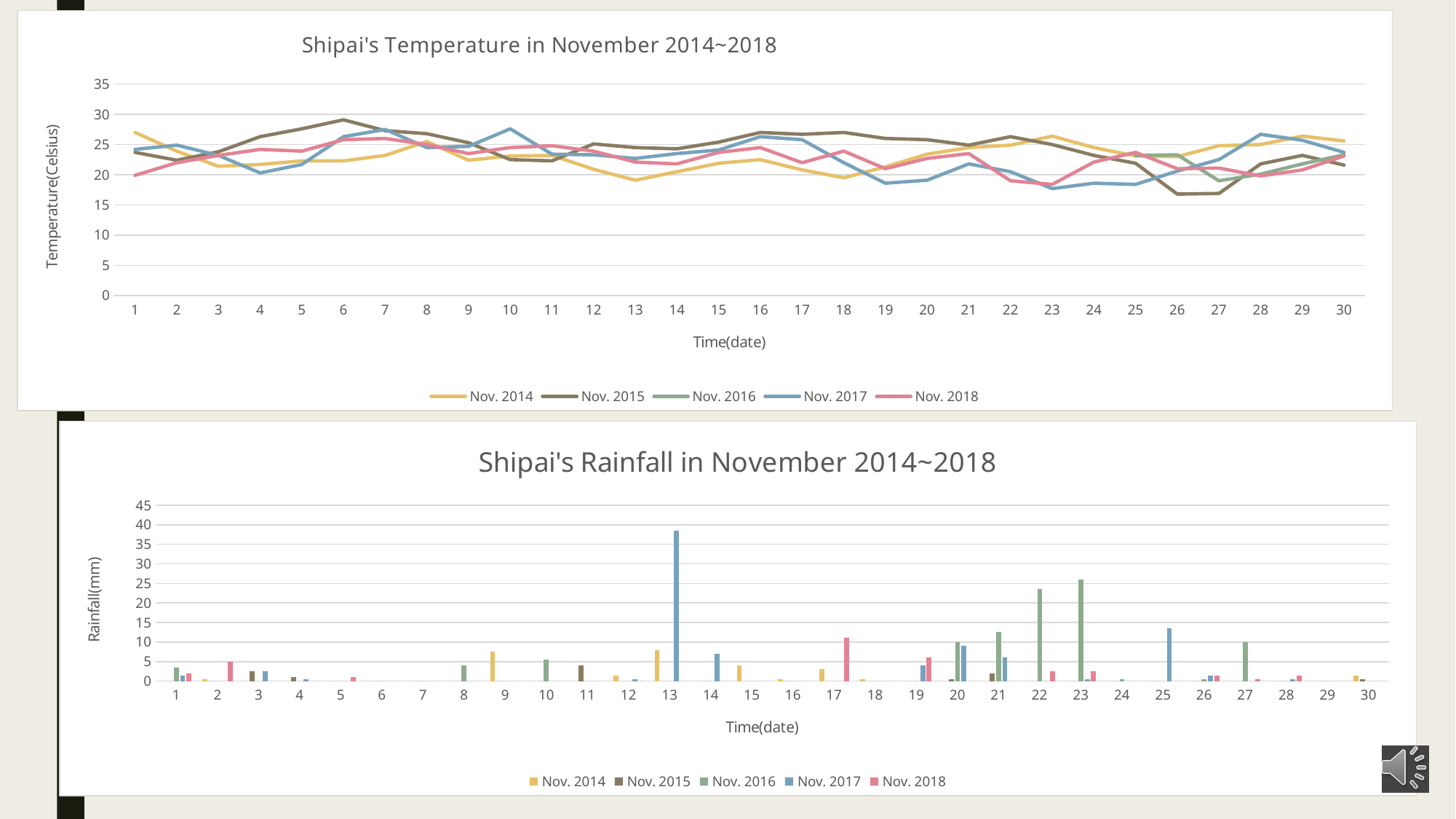
In the rainfall chart, how many dates are shown on the x axis? 30 In the temperature chart, is the Nov. 2015 value on date 6 greater or less than 25? greater In the rainfall chart, which is larger: the Nov. 2017 bar on date 13 or the Nov. 2016 bar on date 23? Nov. 2017 bar on date 13 In the temperature chart, is the Nov. 2015 value on date 26 greater or less than 20? less In the rainfall chart, which date has the tallest bar? 13 In the rainfall chart, is the Nov. 2017 value on date 13 greater or less than 35? greater In the rainfall chart, which series has the single highest bar? Nov. 2017 What is the y-axis title of the rainfall chart? Rainfall(mm) What kind of chart is "Shipai's Temperature in November 2014~2018"? line chart What kind of chart is "Shipai's Rainfall in November 2014~2018"? bar chart In the temperature chart, how many series does the legend list? 5